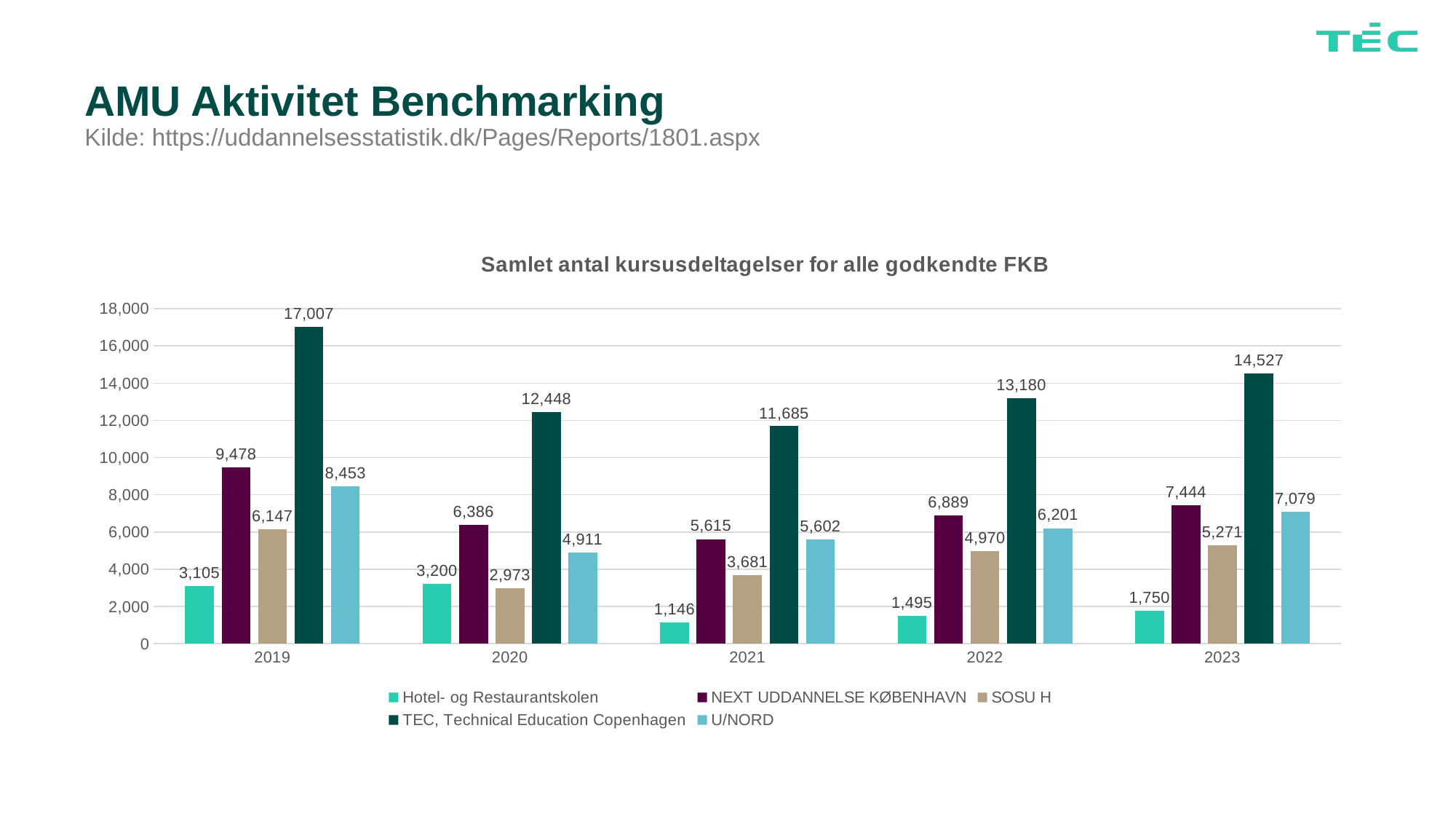
What is the difference between the TEC, Technical Education Copenhagen values in 2023 and 2022? 1,347 What is the title of the chart? Samlet antal kursusdeltagelser for alle godkendte FKB Is the value for SOSU H in 2019 greater or less than 6,000? greater What is the value for Hotel- og Restaurantskolen in 2021? 1,146 How many series does the legend list? 5 What is the value for U/NORD in 2023? 7,079 Which series has the lowest value in 2020? SOSU H Which series has the highest value in 2022? TEC, Technical Education Copenhagen What kind of chart is shown on the slide? Bar chart Which is larger in 2021: NEXT UDDANNELSE KØBENHAVN or SOSU H? NEXT UDDANNELSE KØBENHAVN What is the value for TEC, Technical Education Copenhagen in 2019? 17,007 How many years are shown on the x axis? 5